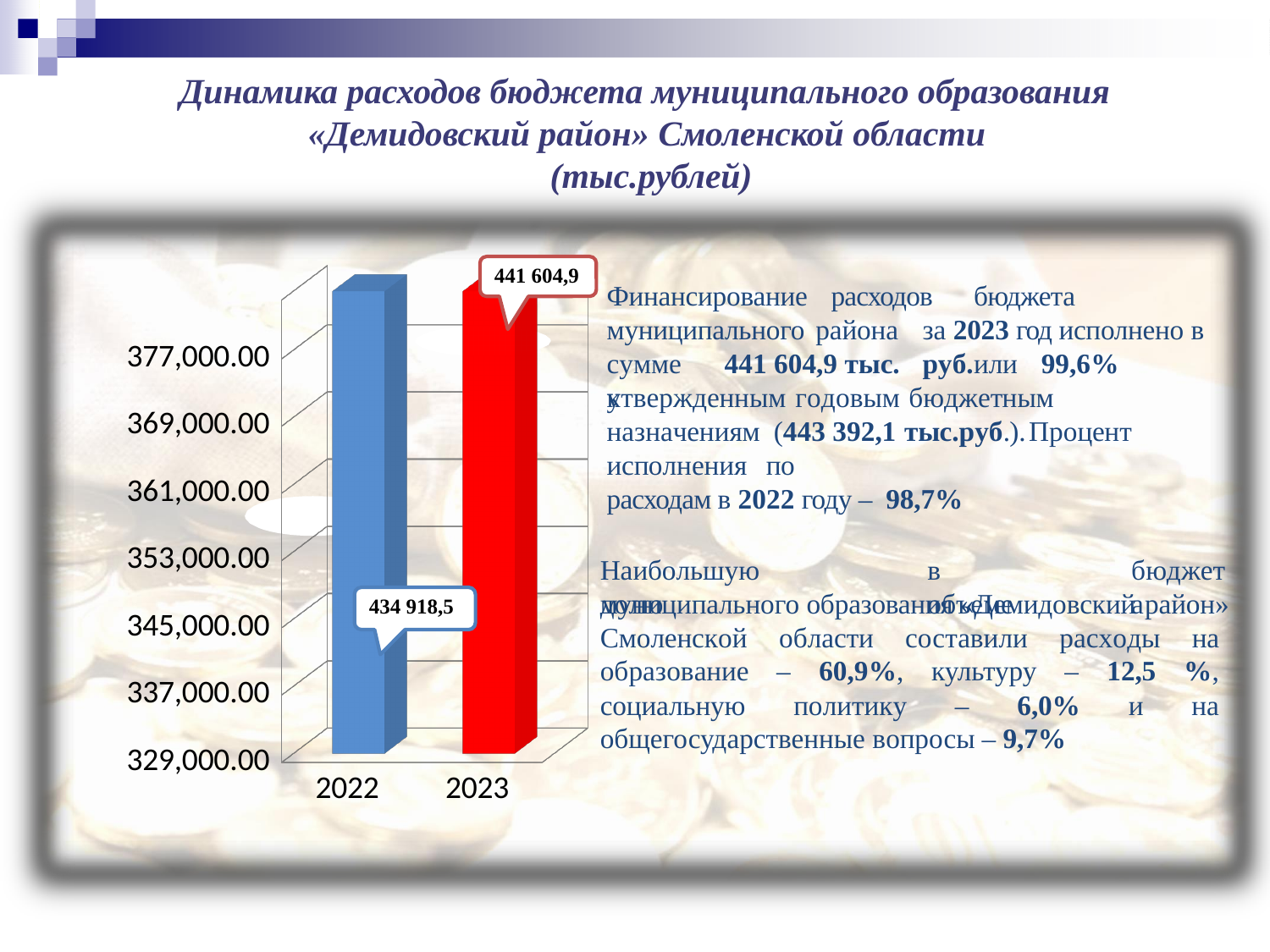
Which year has the higher value? 2023 What kind of chart is shown on the slide? bar chart What colour is the bar for 2022? blue Do the values rise or fall from 2022 to 2023? rise Is the value for 2023 larger or smaller than the value for 2022? larger What is the lowest value shown on the vertical axis? 329,000.00 What is the difference between the 2023 value and the 2022 value? 6 686,4 What colour is the bar for 2023? red What is the value shown for 2023? 441 604,9 Which year has the lower value? 2022 How many years (categories) are plotted on the chart? 2 What is the value shown for 2022? 434 918,5